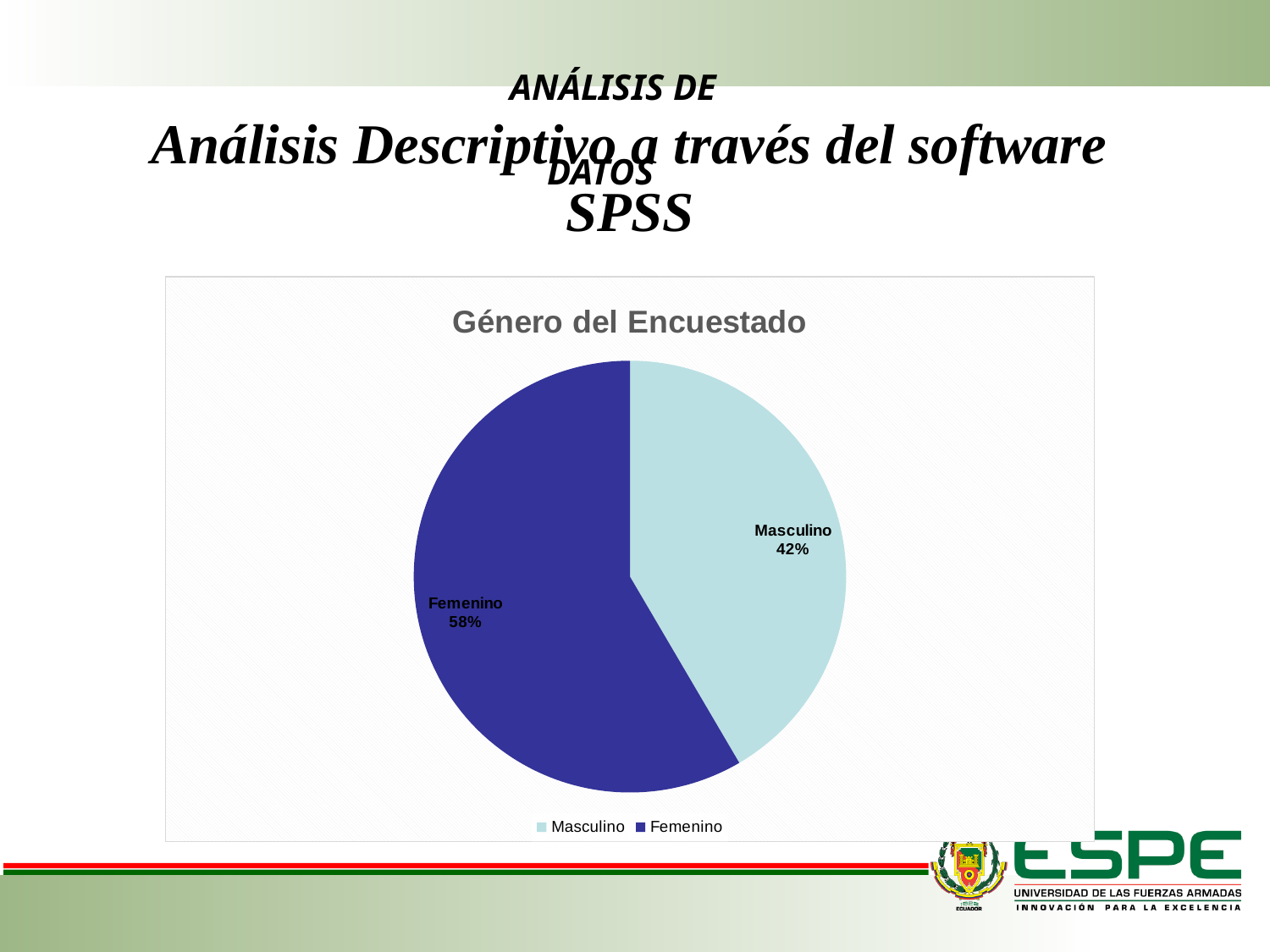
What is the title of the chart? Género del Encuestado Which category has the smallest slice of the pie? Masculino Which category has the largest slice of the pie? Femenino What colour is the Femenino slice? dark blue What share of the pie does Masculino represent? 42% What kind of chart is shown on the slide? pie chart Which is larger, the Masculino slice or the Femenino slice? Femenino How many categories are shown in the pie chart? 2 What is the difference in percentage points between Femenino and Masculino? 16 percentage points How many entries does the legend list? 2 What share of the pie does Femenino represent? 58%